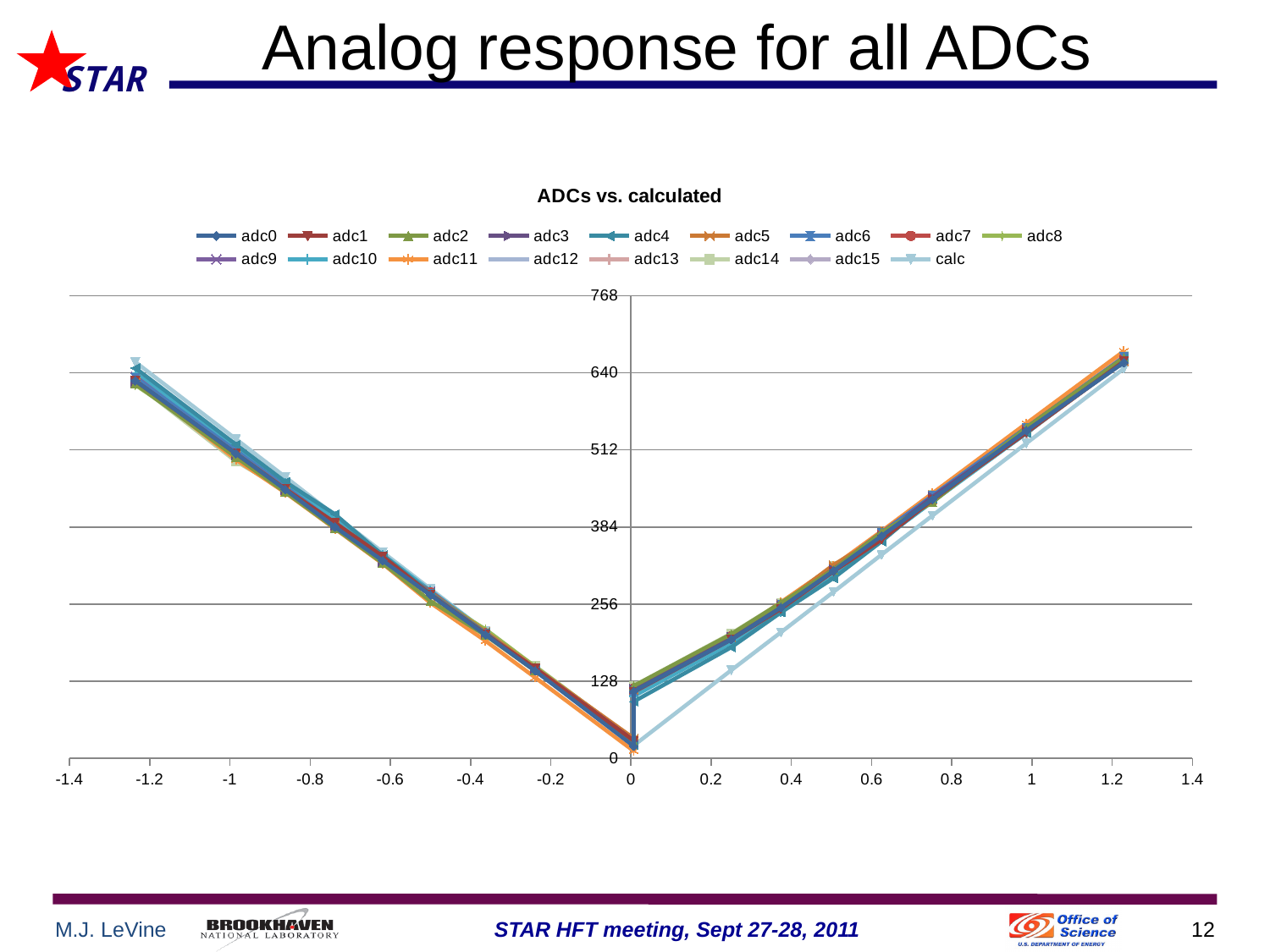
Is the value of the adc series at x = 0.5 greater or less than 256? greater Which legend entry is listed last in the chart's legend? calc What is the title of the chart? ADCs vs. calculated Is the value of the calc series at x = 0.25 greater or less than 256? less Between x = 0 and x = 1.2, do the plotted values rise or fall as x increases? rise Is the value of the calc series at x = 0.5 greater or less than 384? less Between x = -1.2 and x = 0, do the plotted values rise or fall as x increases? fall How many series does the chart's legend list? 17 What kind of chart is shown on the slide? line chart